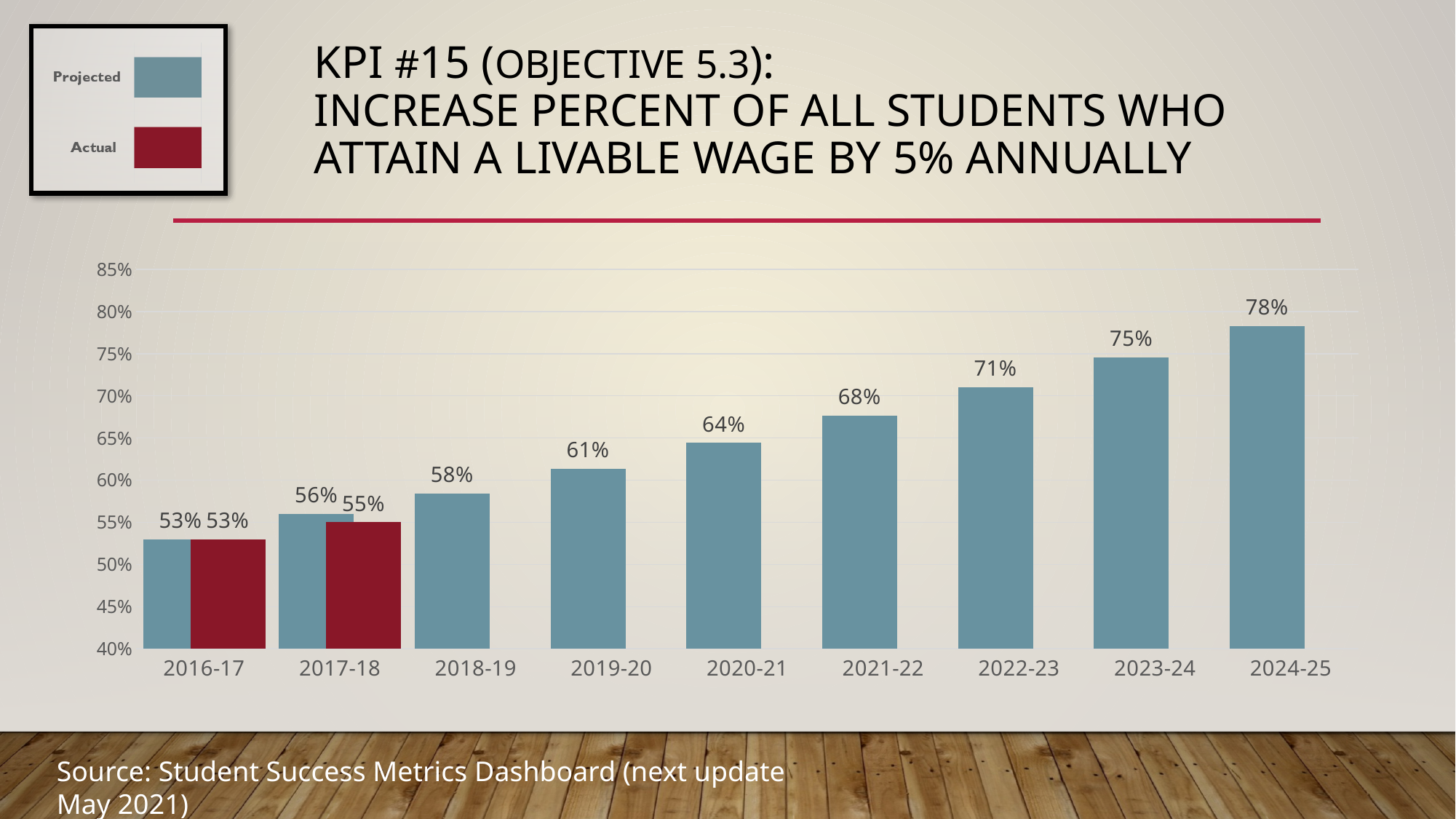
Which year has the highest Projected value? 2024-25 Which is larger, the Projected value for 2017-18 or the Actual value for 2017-18? Projected How many years are shown on the x axis? 9 Which year has the lowest Projected value? 2016-17 How many series does the legend list? 2 What is the Projected value for 2024-25? 78% What is the Projected value for 2020-21? 64% What kind of chart is shown on the slide? Bar chart Do the Projected values rise or fall from 2016-17 to 2024-25? Rise What is the difference between the Projected and Actual values for 2017-18? 1% What is the difference between the Projected values for 2024-25 and 2016-17? 25% What is the Actual value for 2017-18? 55%